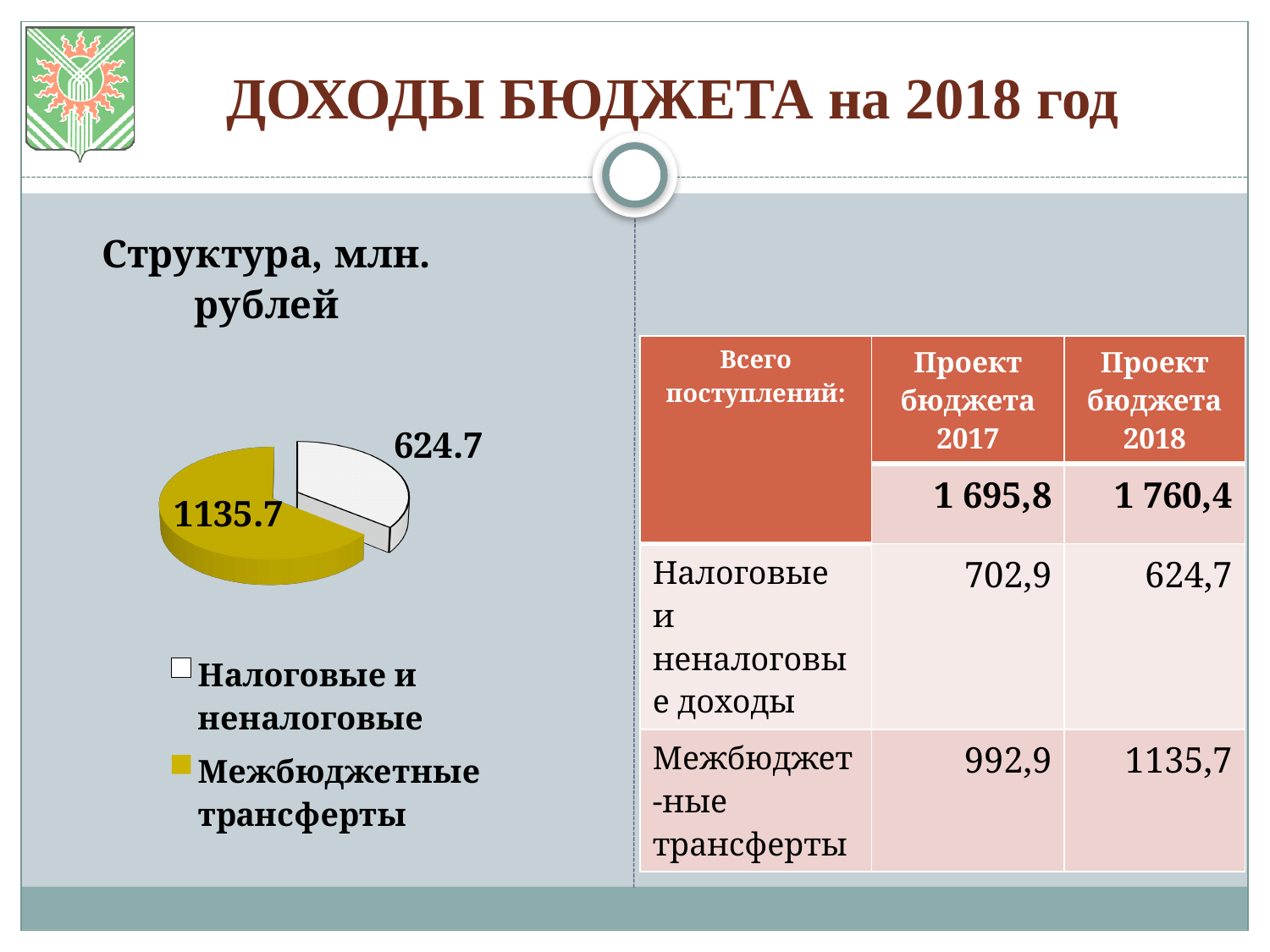
What type of chart is shown on the slide? pie chart What is the value for Межбюджетные трансферты in the pie chart? 1135.7 Which is larger in the pie chart: Налоговые и неналоговые or Межбюджетные трансферты? Межбюджетные трансферты How many slices does the pie chart have? 2 How many entries does the chart legend list? 2 Which category has the largest slice in the pie chart? Межбюджетные трансферты What is the total of the two slices in the pie chart? 1760.4 Which category has the smallest slice in the pie chart? Налоговые и неналоговые What is the value for Налоговые и неналоговые in the pie chart? 624.7 What is the title of the chart? Структура, млн. рублей What colour is the Межбюджетные трансферты slice in the pie chart? yellow What is the difference between the values for Межбюджетные трансферты and Налоговые и неналоговые in the pie chart? 511